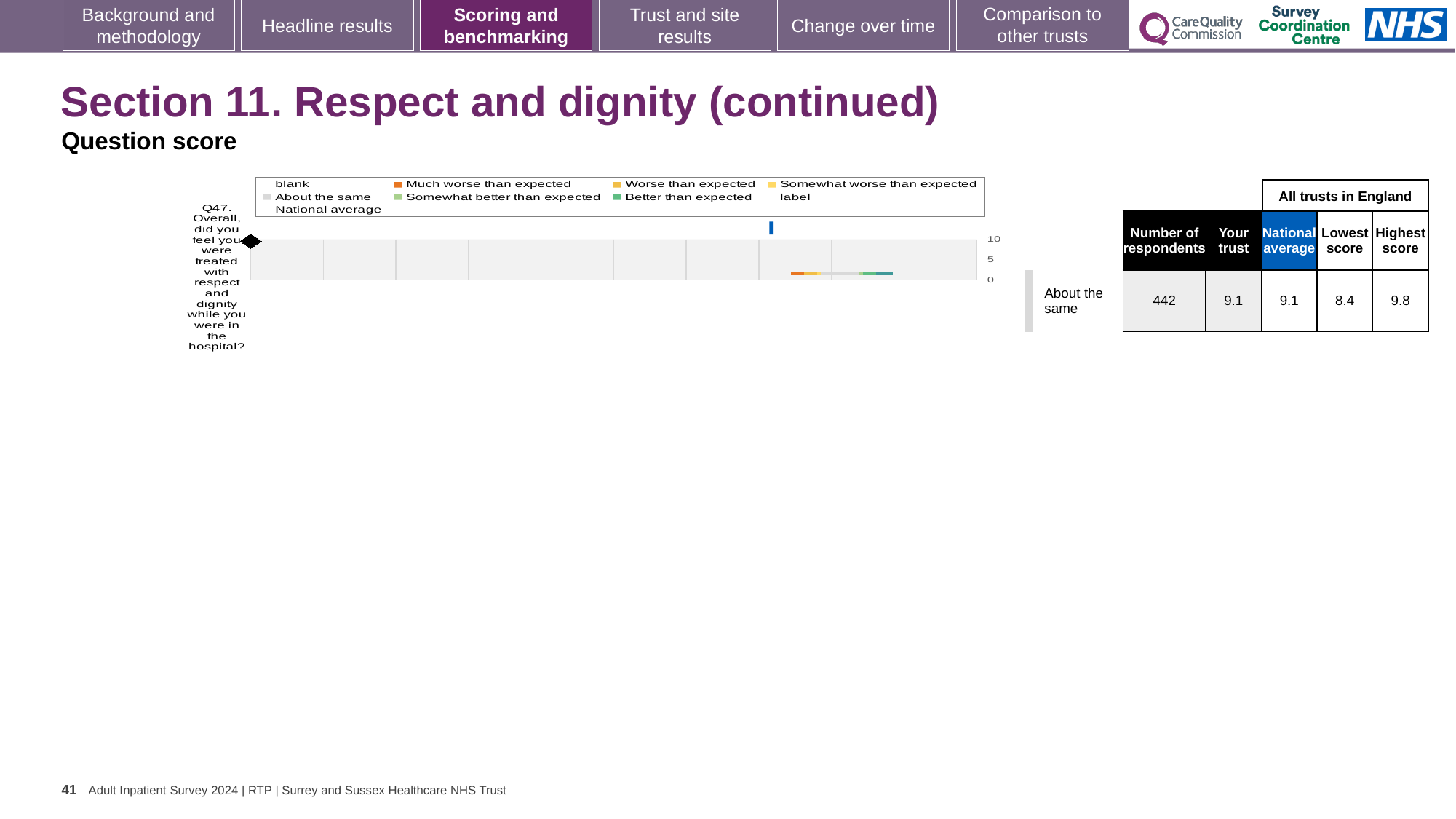
What kind of chart is shown on the slide for Q47? Bar chart What is the Number of respondents for Q47? 442 What is the Lowest score among all trusts in England for Q47? 8.4 Which question number is plotted on the chart? Q47 Which benchmarking category is the trust's Q47 result assigned to? About the same Is the trust's score for Q47 greater or less than 5 on the chart axis? greater How many questions are plotted on the chart? 1 What is the score for Your trust on Q47? 9.1 How many entries does the chart legend list? 9 What is the National average score for Q47? 9.1 What is the difference between the Highest score and the Lowest score for Q47? 1.4 What is the Highest score among all trusts in England for Q47? 9.8